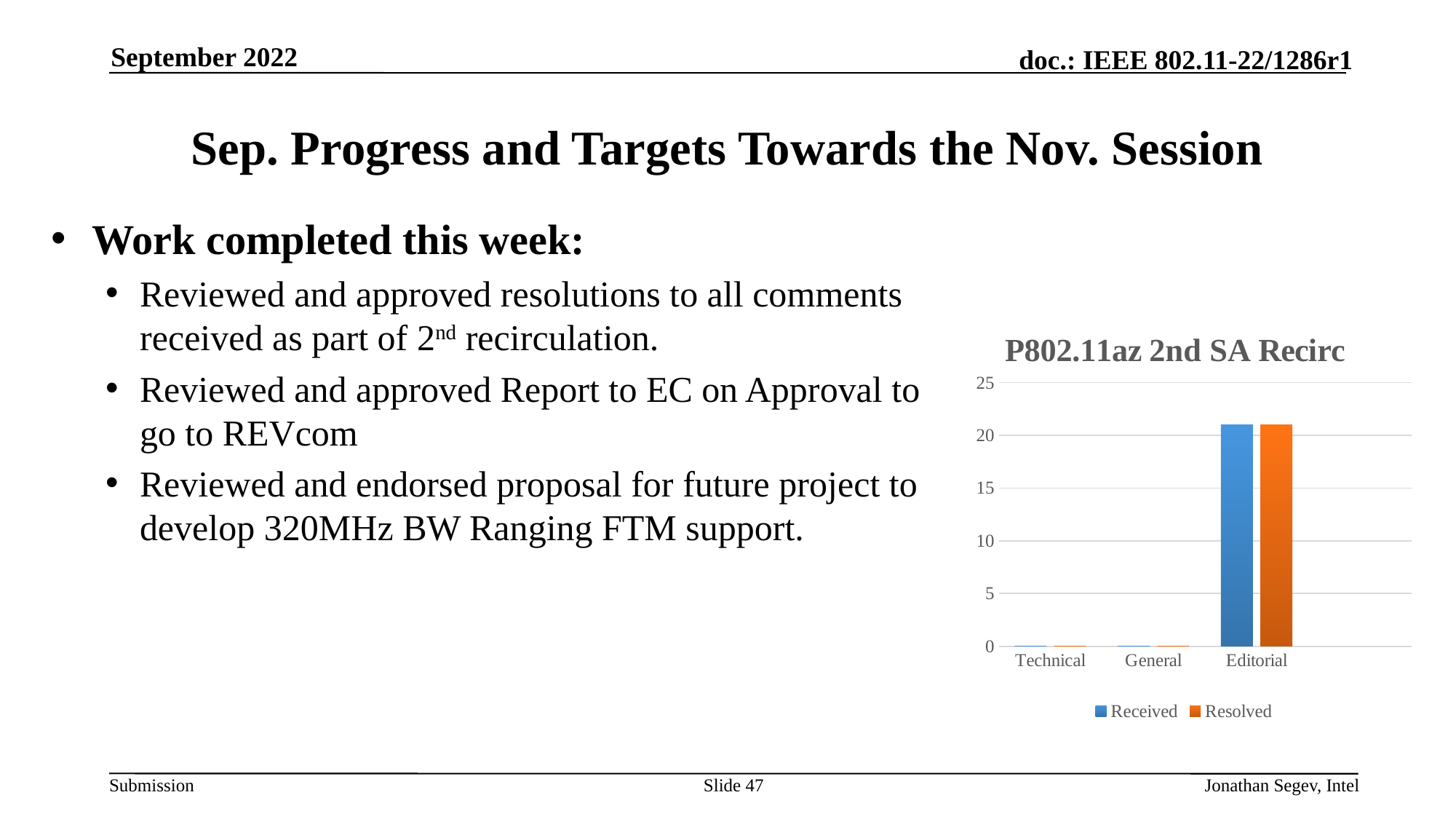
Is the Resolved value for Editorial greater or less than 25? less How many series does the chart legend list? 2 Which category has a larger Resolved value, General or Editorial? Editorial Which category has the highest Received value in the chart? Editorial Which category has the highest Resolved value in the chart? Editorial How many categories are shown on the x axis of the chart? 3 What kind of chart is shown on the slide? bar chart Is the Received value for Editorial greater or less than 20? greater What are the two series named in the chart legend? Received and Resolved Which category has a larger Received value, Technical or Editorial? Editorial What is the title of the chart on the slide? P802.11az 2nd SA Recirc Is the Received value for Editorial greater or less than 15? greater